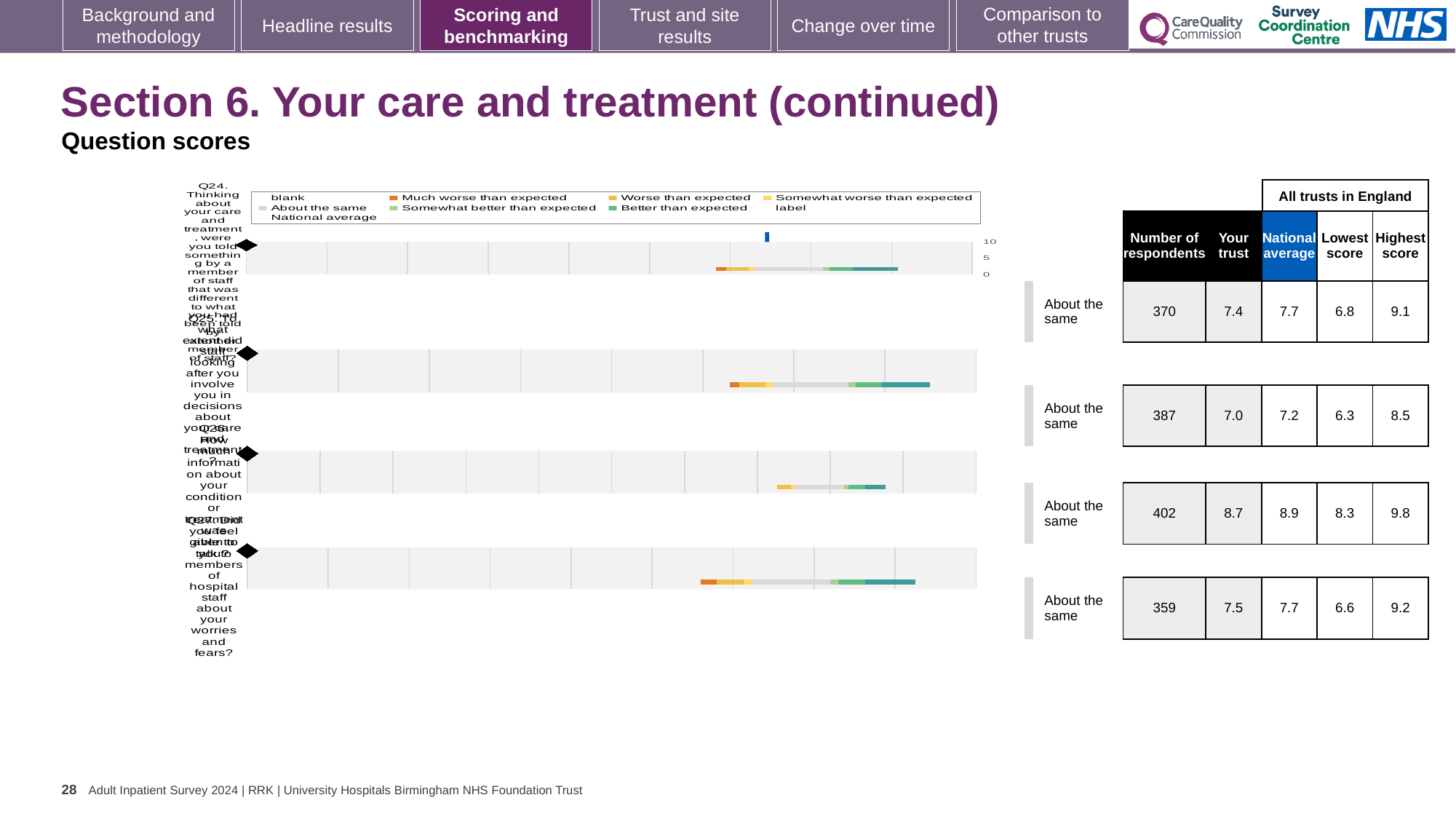
What benchmark category is shown for the Q25 row (second row)? About the same Which question row has the highest 'Your trust' score? Q26 Which is larger, the 'Your trust' score for Q24 or for Q25? Q24 How many respondents are listed for the Q26 row (third row)? 402 For the Q24 row, what is the difference between the national average and the 'Your trust' score? 0.3 What is the national average score shown for the Q25 row (second row)? 7.2 What is the lowest score across all trusts in England for the Q27 row (fourth row)? 6.6 How many entries does the legend at the top of the charts list? 9 In the table beside the charts, what is the 'Your trust' score for the Q24 row (first row)? 7.4 Which question row has the lowest number of respondents? Q27 What kind of chart is used for each question row on the slide? Bar chart What is the highest score across all trusts in England for the Q26 row (third row)? 9.8